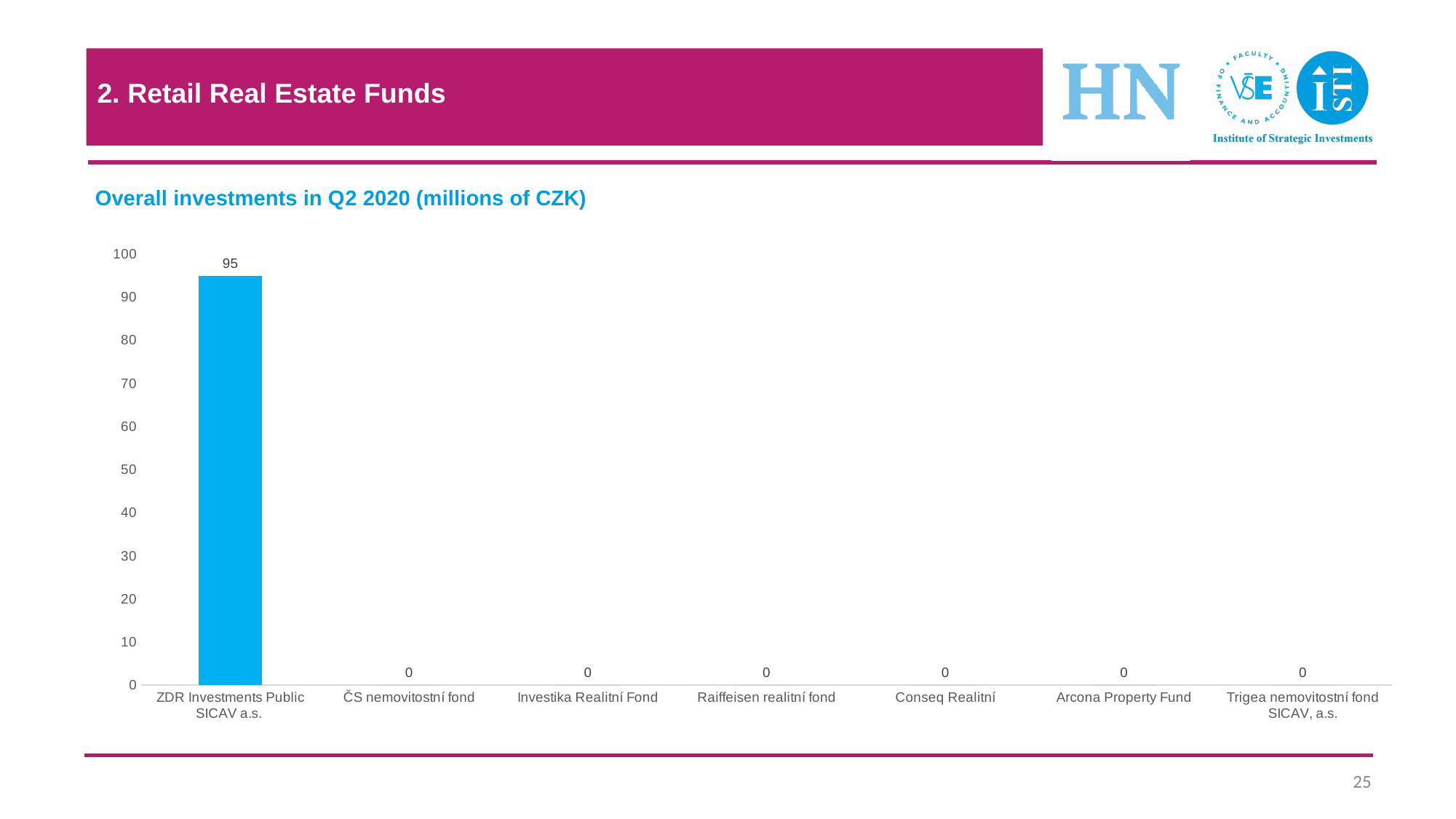
Is the value for ZDR Investments Public SICAV a.s. greater or less than 90? greater What is the value for Arcona Property Fund? 0 What is the value for ČS nemovitostní fond? 0 How many categories have a value of 0? 6 What is the value for ZDR Investments Public SICAV a.s.? 95 What is the difference between the values for ZDR Investments Public SICAV a.s. and Investika Realitní Fond? 95 What kind of chart is shown on the slide? bar chart How many categories are shown on the x axis? 7 What is the value for Trigea nemovitostní fond SICAV, a.s.? 0 What is the title of the chart? Overall investments in Q2 2020 (millions of CZK) Which is larger, the value for ZDR Investments Public SICAV a.s. or the value for Conseq Realitní? ZDR Investments Public SICAV a.s. Which category has the highest value? ZDR Investments Public SICAV a.s.